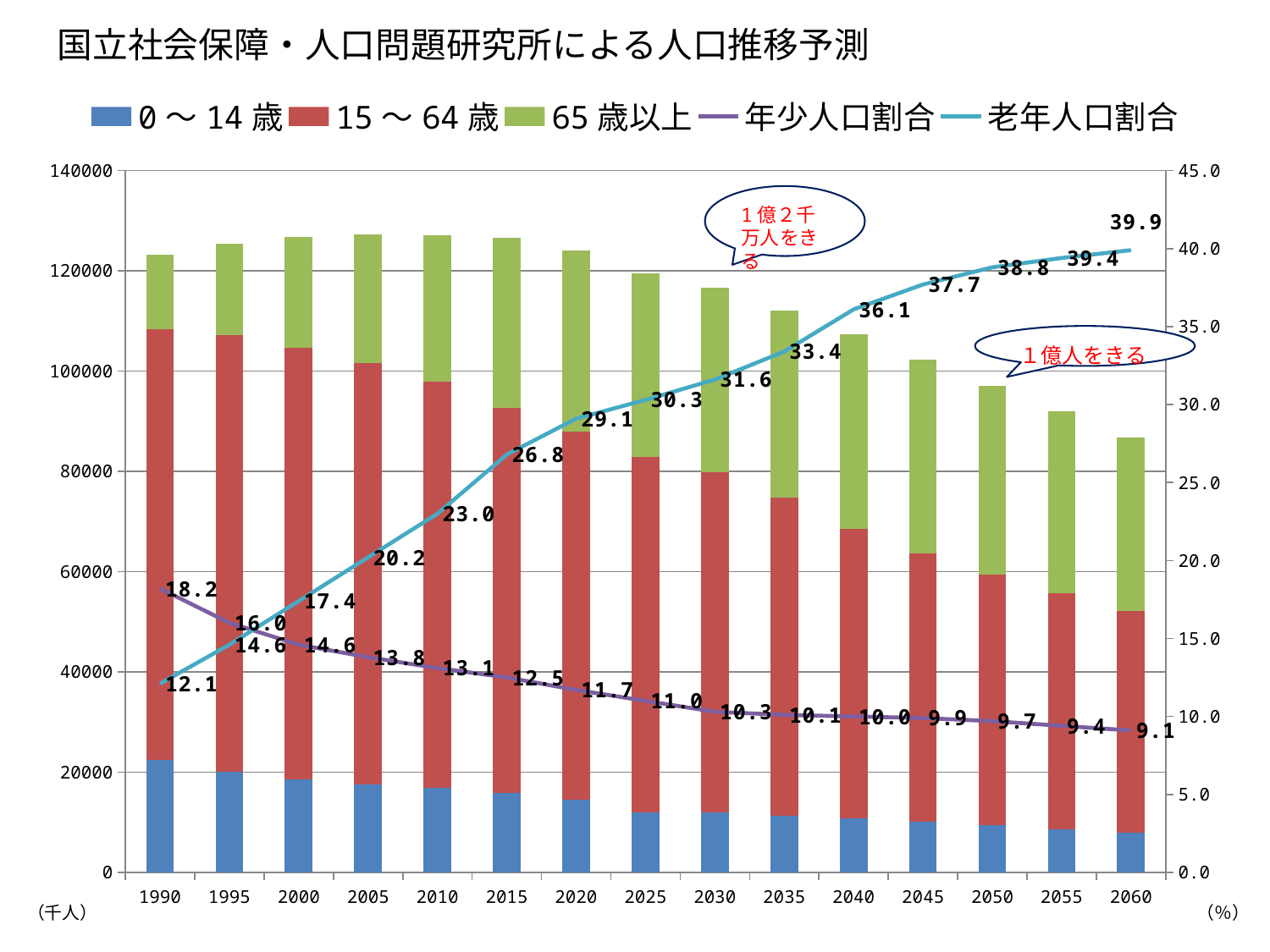
In which year is 老年人口割合 highest? 2060 Does 年少人口割合 rise or fall from 1990 to 2060? fall How many years are shown on the x axis? 15 Is the total stacked bar for 2060 greater or less than 100000? less Is the total stacked bar for 1990 greater or less than 120000? greater How many series does the legend list? 5 In which year is 年少人口割合 lowest? 2060 What is the value of 年少人口割合 in 1990? 18.2 What is the difference between 老年人口割合 in 2060 and in 1990? 27.8 What is the value of 老年人口割合 in 2010? 23.0 What is the value of 老年人口割合 in 2060? 39.9 Which is larger in 2000: 老年人口割合 or 年少人口割合? 老年人口割合